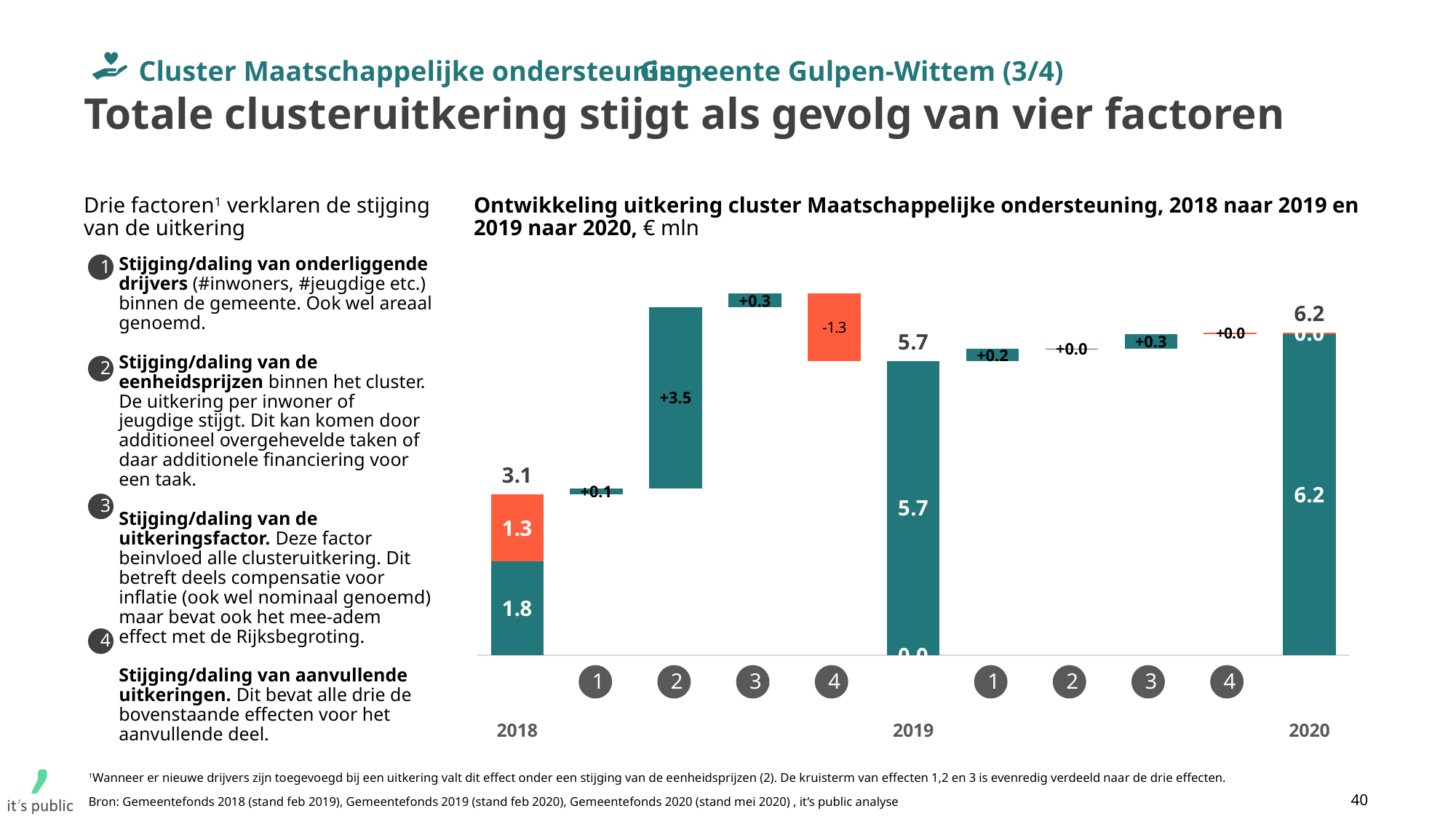
What is the total uitkering shown for 2019 in the chart? 5.7 What is the total uitkering shown for 2020 in the chart? 6.2 What is the value of factor 2 (eenheidsprijzen) in the step from 2018 to 2019? +3.5 Which year has the higher total uitkering, 2019 or 2020? 2020 Does the total uitkering rise or fall from 2018 to 2020? Rise What is the value of factor 4 (aanvullende uitkeringen) in the step from 2018 to 2019? -1.3 What are the two components that make up the 2018 bar of 3.1? 1.8 and 1.3 Which of the four factors has the largest effect in the step from 2018 to 2019? Factor 2 (+3.5) What is the total uitkering shown for 2018 in the chart? 3.1 What is the difference between the 2020 total (6.2) and the 2018 total (3.1)? 3.1 What is the value of factor 3 (uitkeringsfactor) in the step from 2019 to 2020? +0.3 What is the value of factor 1 (onderliggende drijvers) in the step from 2019 to 2020? +0.2